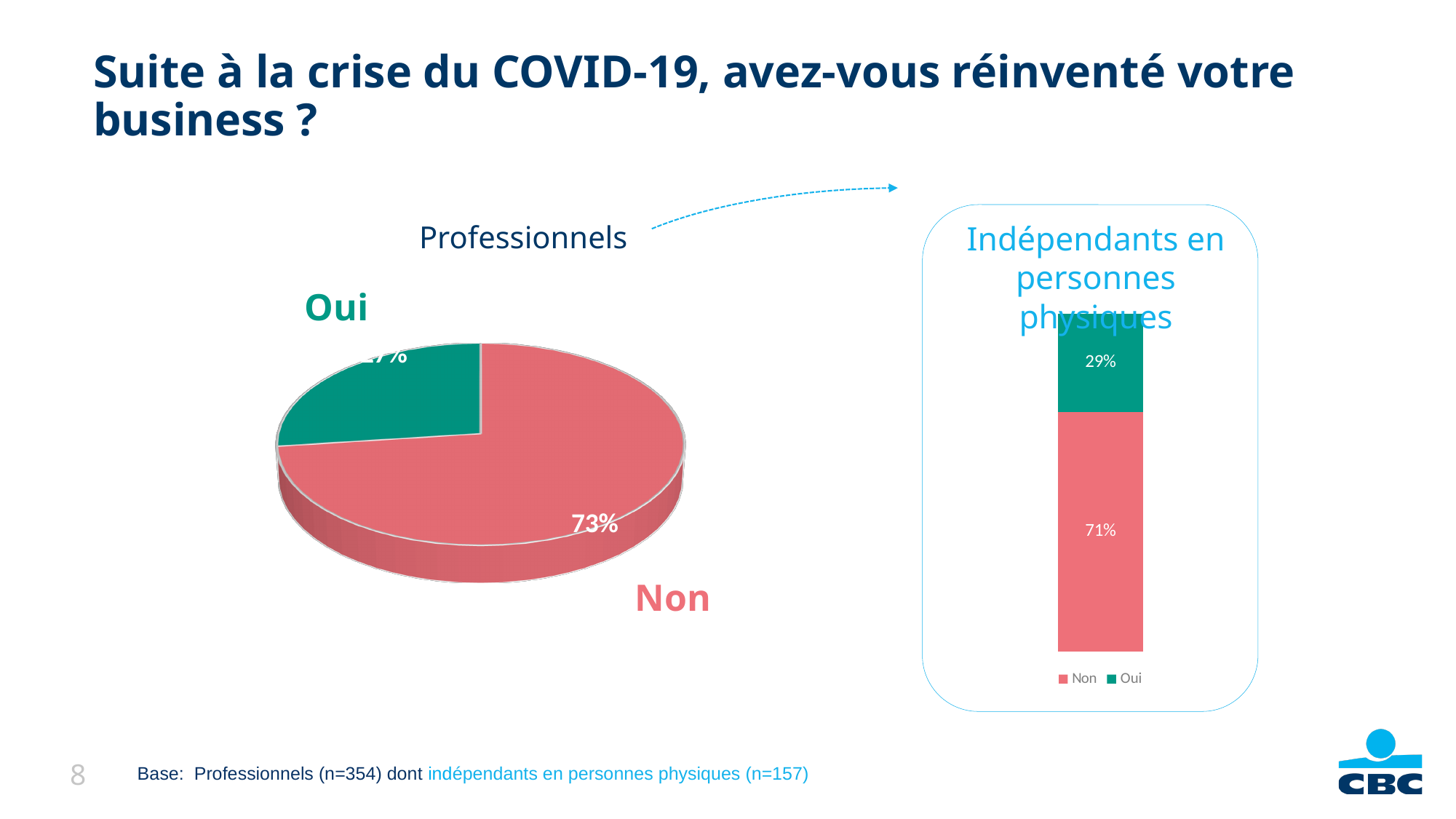
In the "Professionnels" pie chart, which slice is larger, "Oui" or "Non"? Non In the "Indépendants en personnes physiques" chart, what is the total of the stacked bar? 100% In the "Indépendants en personnes physiques" chart, what percentage is shown for "Non"? 71% What kind of chart is the "Indépendants en personnes physiques" chart on the right? bar chart What kind of chart is the "Professionnels" chart on the left? pie chart In the "Indépendants en personnes physiques" chart, what percentage is shown for "Oui"? 29% How many slices does the "Professionnels" pie chart have? 2 In the "Indépendants en personnes physiques" chart, what is the difference between the "Non" and "Oui" percentages? 42 percentage points In the "Indépendants en personnes physiques" chart, which segment is larger, "Non" or "Oui"? Non In the pie chart titled "Professionnels", what percentage is shown for "Non"? 73% How many series does the legend of the "Indépendants en personnes physiques" chart list? 2 In the "Indépendants en personnes physiques" chart, what colour represents "Oui"? green